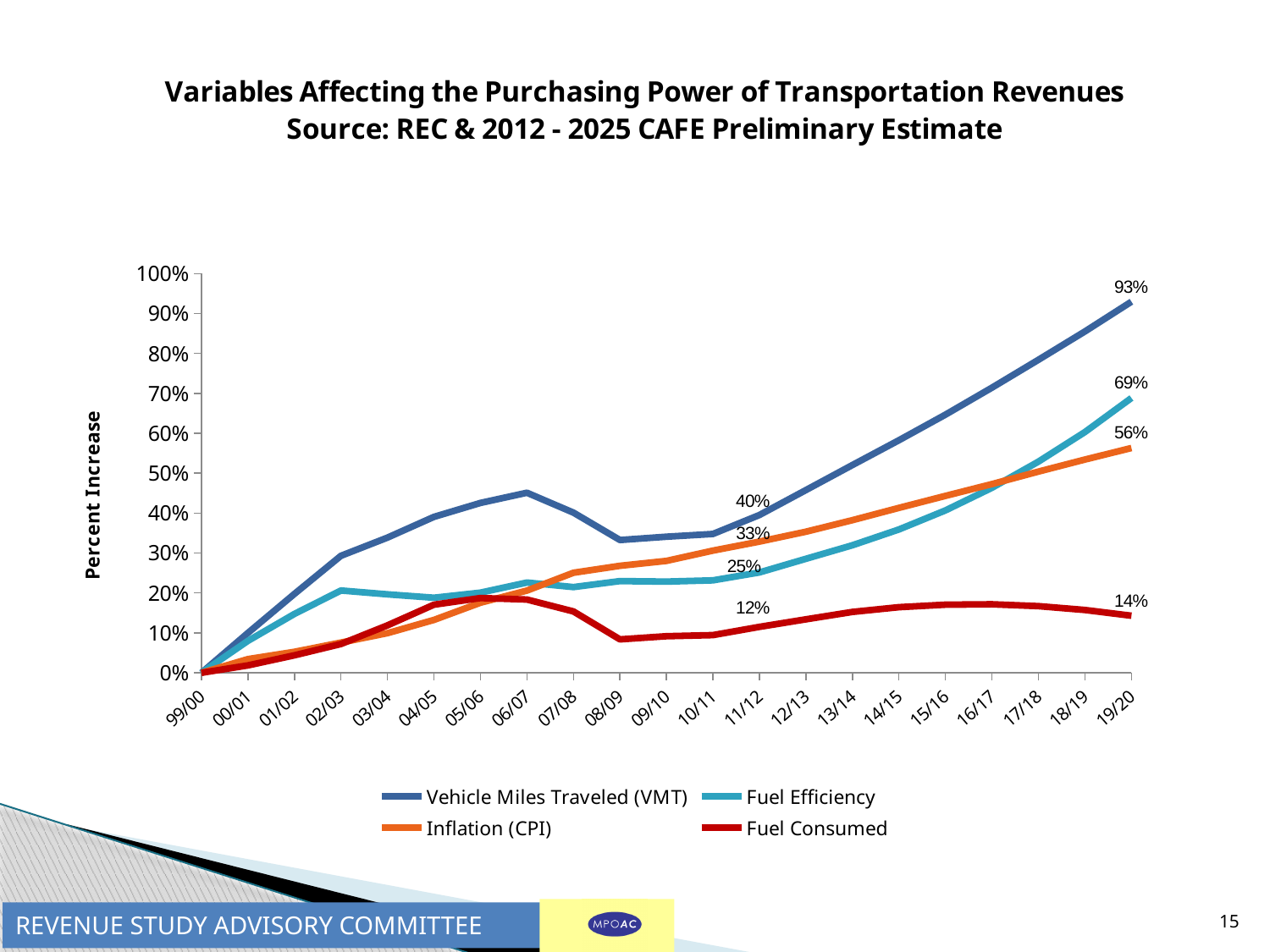
At 19/20, which is larger: Fuel Efficiency or Inflation (CPI)? Fuel Efficiency What is the value for Inflation (CPI) at 19/20? 56% What is the value for Fuel Consumed at 19/20? 14% What type of chart is shown on the slide? line chart What is the label of the vertical axis? Percent Increase What is the value for Fuel Efficiency at 19/20? 69% What is the value for Vehicle Miles Traveled (VMT) at 19/20? 93% Which series has the lowest value at 19/20? Fuel Consumed Which series has the highest value at 19/20? Vehicle Miles Traveled (VMT) Is the value for Vehicle Miles Traveled (VMT) at 06/07 greater or less than 40%? greater What is the difference between the Vehicle Miles Traveled (VMT) value and the Fuel Efficiency value at 19/20? 24% How many series does the legend list? 4